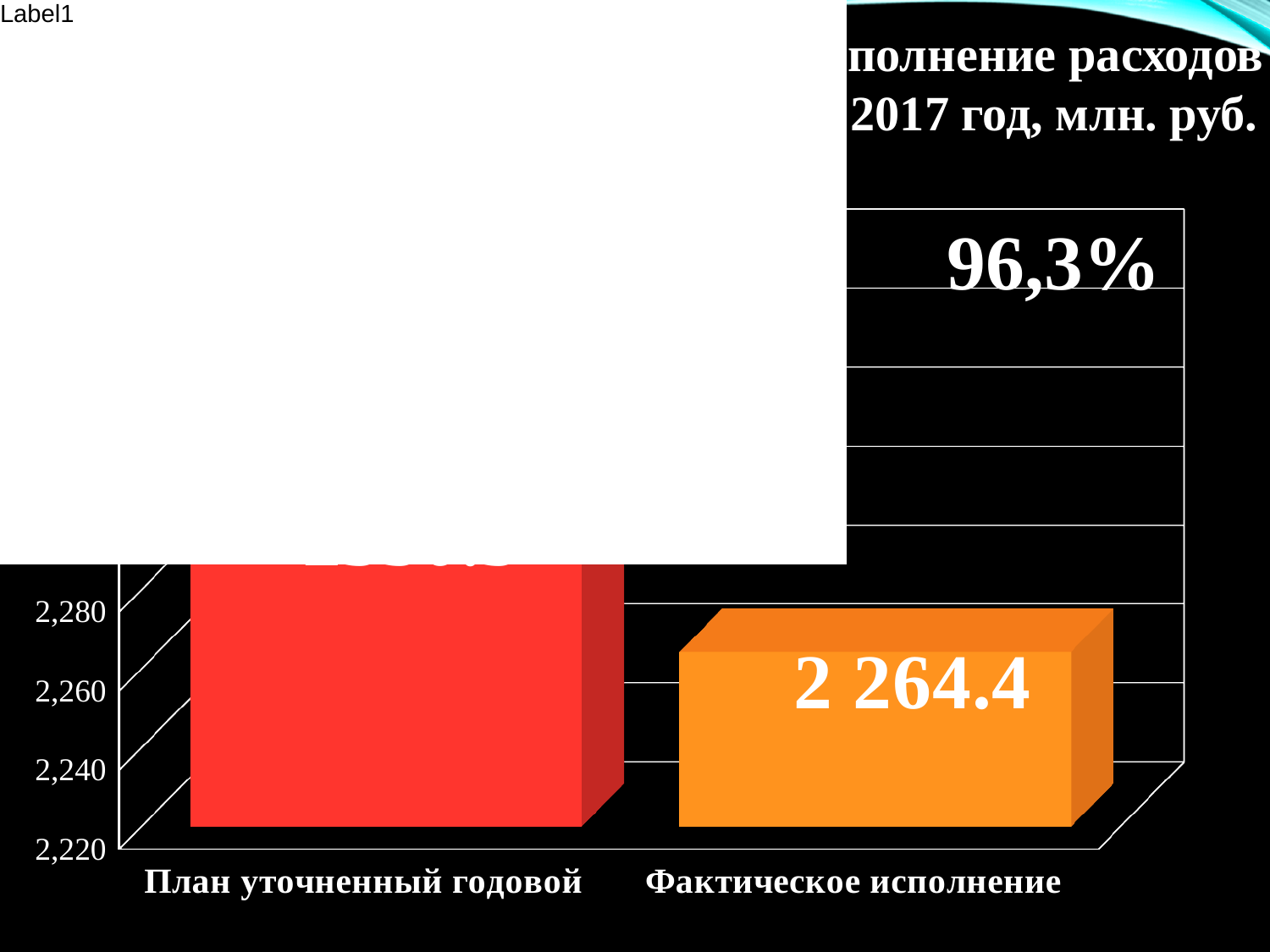
Which category has the highest value? План уточненный годовой Is the value for План уточненный годовой greater or less than 2,280? greater Is the value for Фактическое исполнение greater or less than 2,280? less What percentage is printed on the chart? 96,3% What colour is the bar for Фактическое исполнение? orange How many categories are shown on the x axis? 2 What is the value for Фактическое исполнение? 2 264.4 What kind of chart is shown on the slide? bar chart Is the value for Фактическое исполнение greater or less than 2,260? greater Which category has the higher bar, План уточненный годовой or Фактическое исполнение? План уточненный годовой Which category has the lowest value? Фактическое исполнение